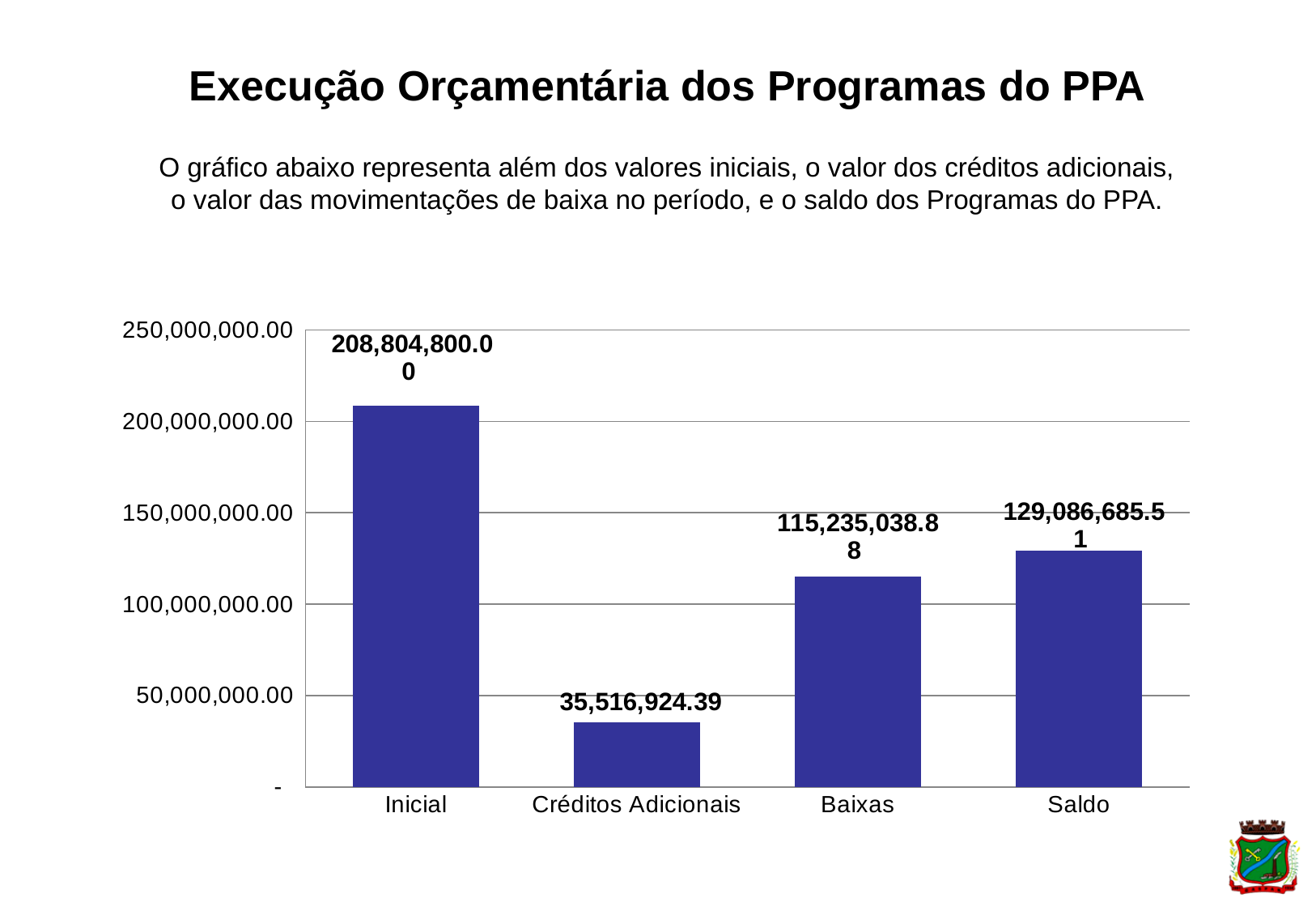
How many categories are shown on the x axis? 4 What is the difference between the Inicial value and the Créditos Adicionais value? 173,287,875.61 What is the value of the Inicial bar? 208,804,800.00 What kind of chart is shown on the slide? bar chart What is the difference between the Saldo value and the Baixas value? 13,851,646.63 Is the value for Baixas greater or less than 100,000,000.00? greater What is the value shown for Baixas? 115,235,038.88 Which is larger, the value for Baixas or the value for Saldo? Saldo Which category has the lowest value? Créditos Adicionais What is the value shown for Créditos Adicionais? 35,516,924.39 Which category has the highest value? Inicial What is the value shown for Saldo? 129,086,685.51